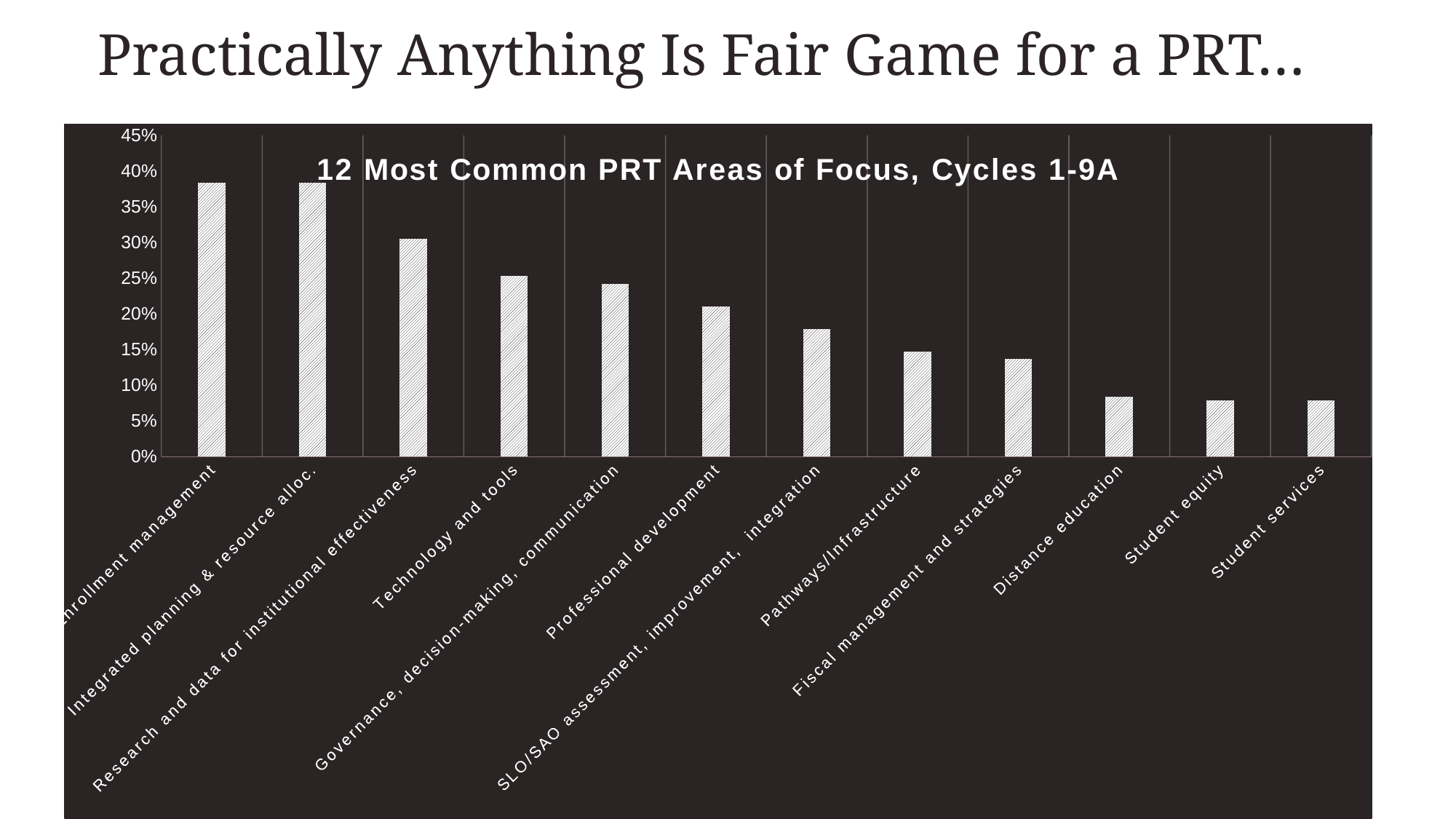
Is the value for Fiscal management and strategies greater or less than 15%? less What kind of chart is shown on the slide? bar chart Which is larger, the value for Enrollment management or the value for Technology and tools? Enrollment management Is the value for Distance education greater or less than 10%? less Is the value for SLO/SAO assessment, improvement, integration greater or less than 20%? less What is the title of the chart? 12 Most Common PRT Areas of Focus, Cycles 1-9A Which is larger, the value for Professional development or the value for Student equity? Professional development How many categories are plotted in the chart? 12 Do the values rise or fall moving from left to right along the x axis? fall